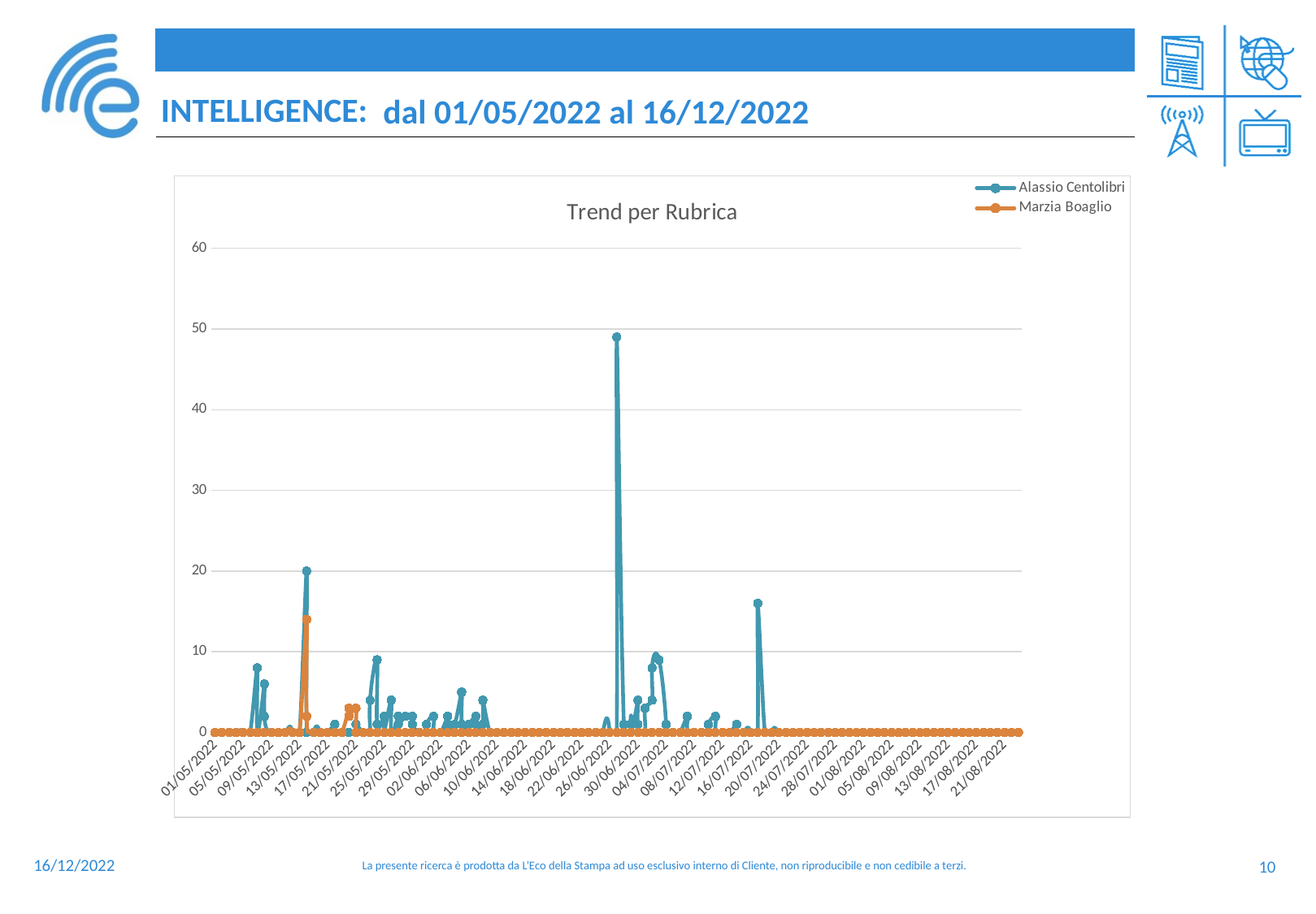
Is the highest value reached by the Alassio Centolibri series greater or less than 50? less What is the title of the chart? Trend per Rubrica Which series has the lower peak value in the chart? Marzia Boaglio Is the value of the Alassio Centolibri series at its peak near 20/07/2022 greater or less than 20? less Is the highest value reached by the Marzia Boaglio series greater or less than 10? greater What kind of chart is shown on the slide? line chart Which colour is used for the Marzia Boaglio series in the chart? orange How many series does the legend of the chart list? 2 Which series reaches the higher peak value, Alassio Centolibri or Marzia Boaglio? Alassio Centolibri